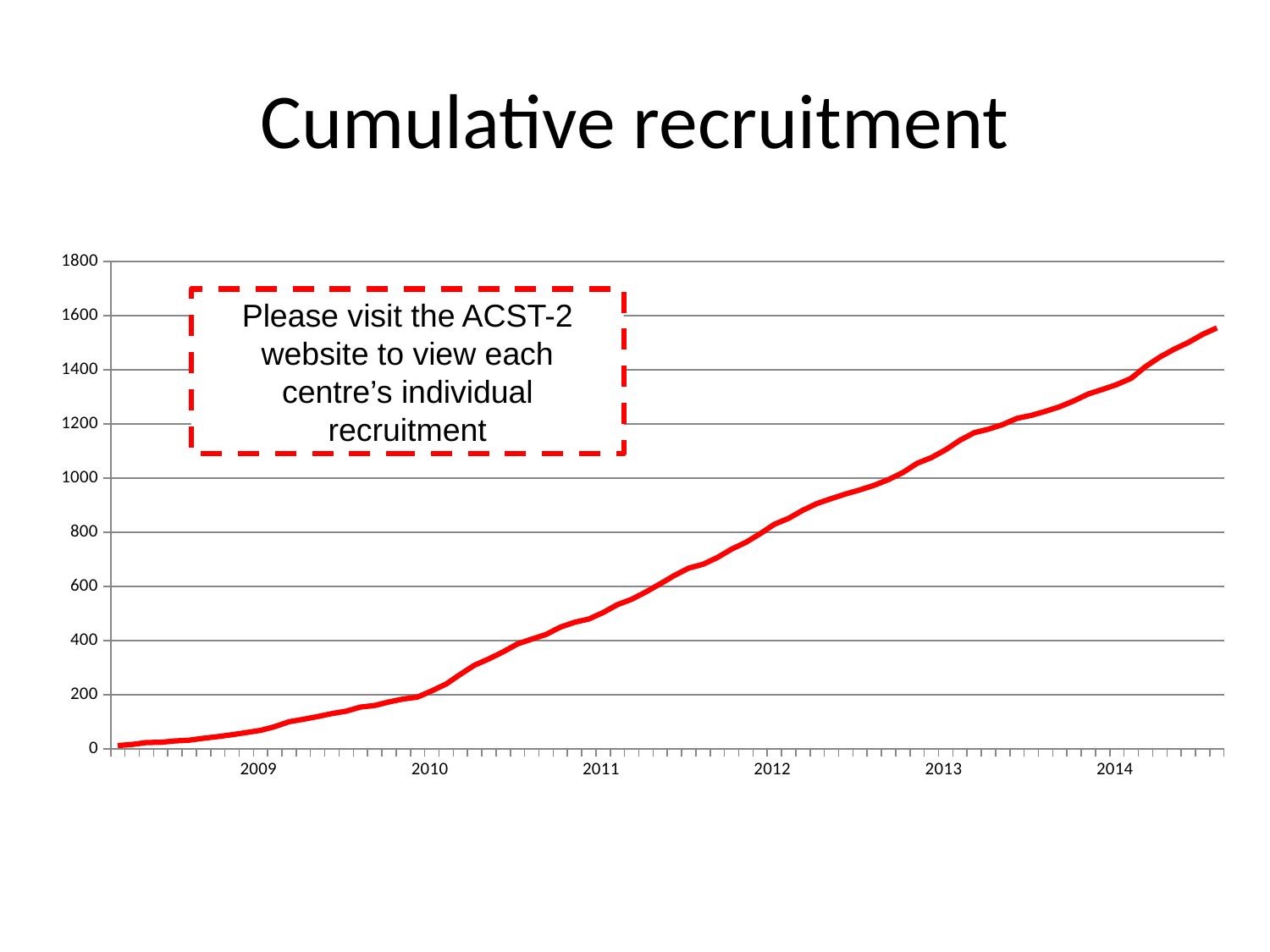
Is the value at the 2013 tick greater or less than 1000? greater Do the values on the chart rise or fall from 2009 to 2014? rise Is the value at the 2011 tick greater or less than 600? less Is the value at the 2014 tick greater or less than 1200? greater What is the highest value shown on the vertical axis of the chart? 1800 What is the title of the chart on the slide? Cumulative recruitment What kind of chart is shown on the slide? line chart